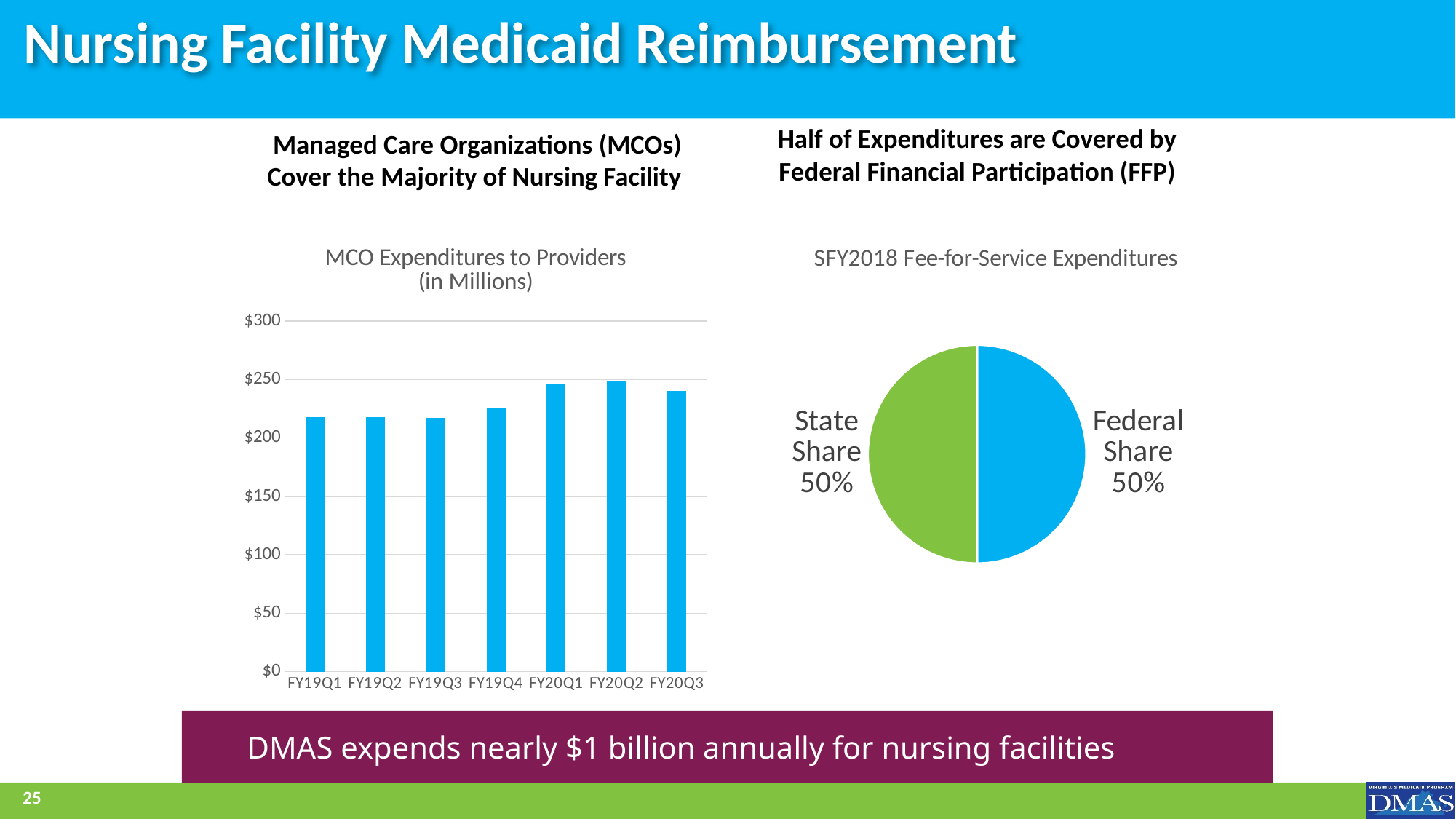
On the 'MCO Expenditures to Providers (in Millions)' chart, is the value for FY20Q1 greater or less than $200? greater On the 'MCO Expenditures to Providers (in Millions)' chart, do the values overall rise or fall from FY19Q1 to FY20Q2? rise On the 'MCO Expenditures to Providers (in Millions)' chart, is the value for FY19Q3 greater or less than $200? greater What kind of chart is the 'MCO Expenditures to Providers (in Millions)' chart? bar chart On the 'MCO Expenditures to Providers (in Millions)' chart, which is larger, FY19Q2 or FY20Q3? FY20Q3 On the 'SFY2018 Fee-for-Service Expenditures' pie chart, what share is the State Share? 50% On the 'MCO Expenditures to Providers (in Millions)' chart, which is larger, FY20Q1 or FY19Q1? FY20Q1 What kind of chart is the 'SFY2018 Fee-for-Service Expenditures' chart? pie chart On the 'SFY2018 Fee-for-Service Expenditures' pie chart, what share is the Federal Share? 50% On the 'MCO Expenditures to Providers (in Millions)' chart, is the value for FY19Q1 greater or less than $250? less How many quarters are plotted on the 'MCO Expenditures to Providers (in Millions)' chart? 7 How many slices does the 'SFY2018 Fee-for-Service Expenditures' pie chart have? 2